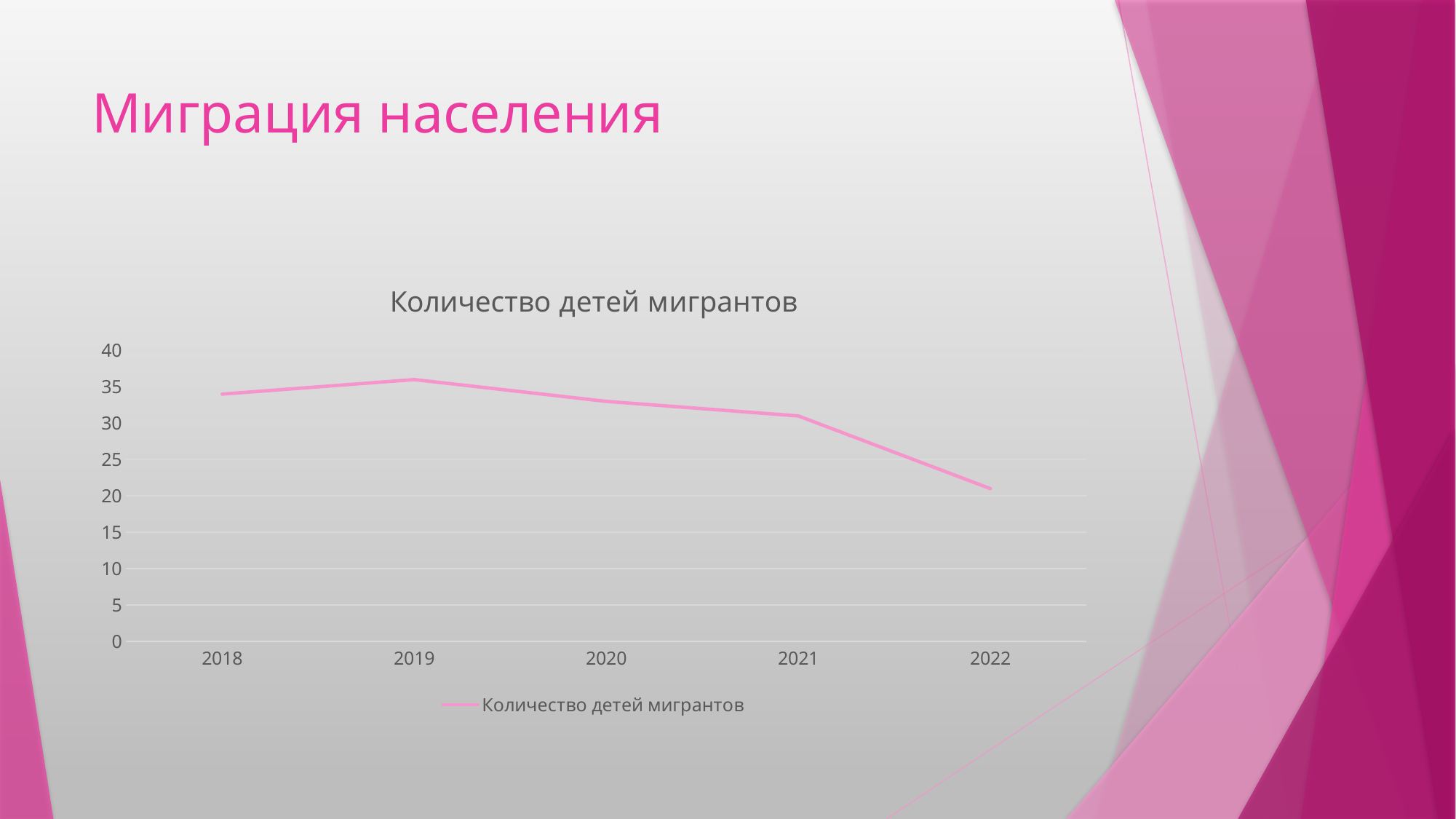
Which year has the larger value, 2018 or 2022? 2018 How many series does the chart legend list? 1 In which year is the value for Количество детей мигрантов highest? 2019 In which year is the value for Количество детей мигрантов lowest? 2022 What type of chart is shown on the slide? Line chart Is the value for 2021 greater or less than 35? less How many years are plotted on the x axis of the chart? 5 Is the value for 2020 greater or less than 30? greater What is the title of the chart? Количество детей мигрантов Does the value for Количество детей мигрантов rise or fall from 2019 to 2022? fall Is the value for 2018 greater or less than 30? greater